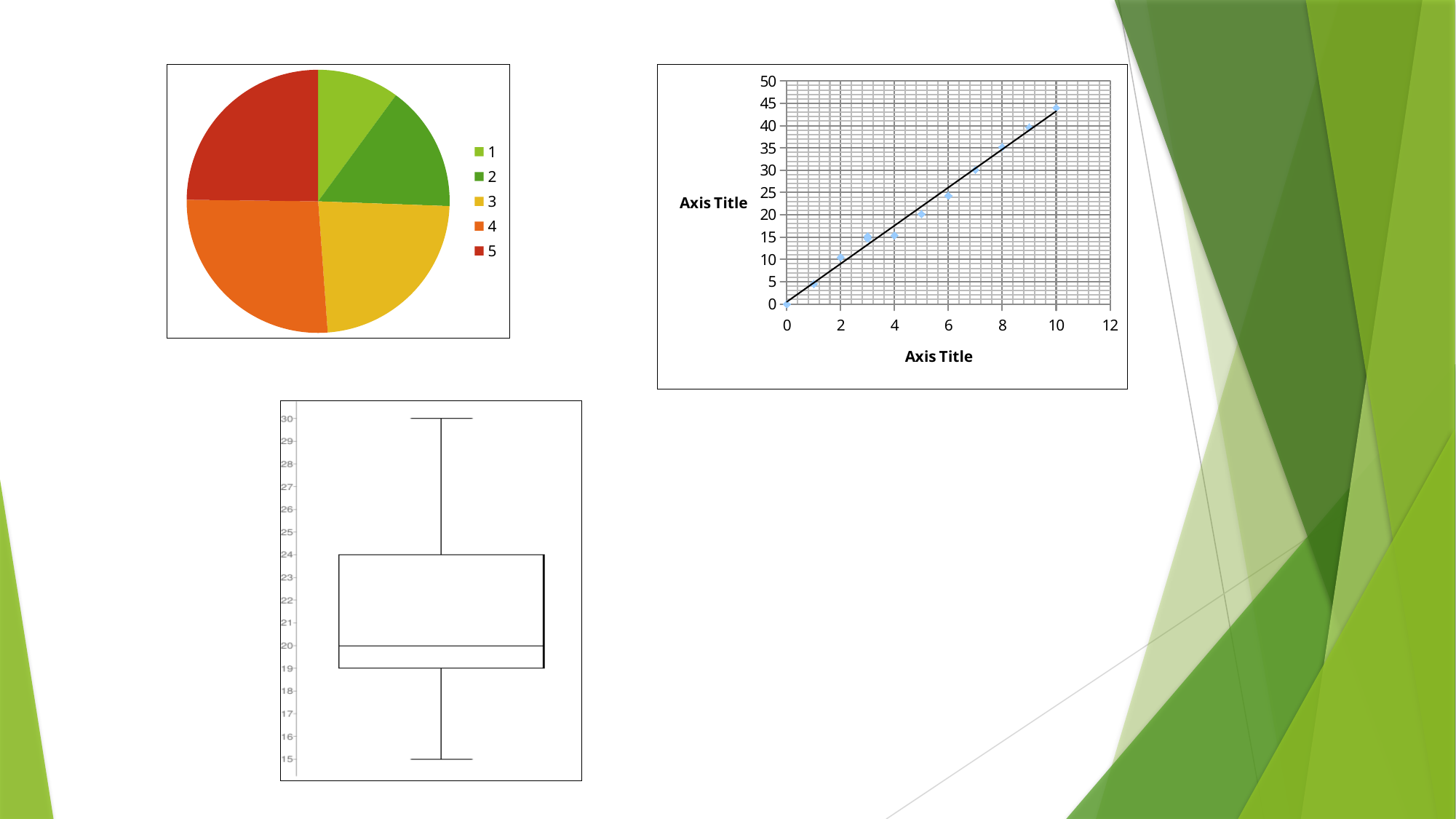
What kind of chart is the top-right chart on the slide? scatter chart In the top-right scatter chart, is the value at x = 10 greater or less than 40? greater How many entries does the legend of the top-left pie chart list? 5 In the top-left pie chart, what colour is slice 5? red What kind of chart is the bottom-left chart on the slide? box plot In the top-left pie chart, which slice is the smallest? 1 In the top-right scatter chart, is the value at x = 2 greater or less than 15? less In the top-left pie chart, which slice is larger, 1 or 2? 2 In the bottom-left box plot, what is the median value? 20 In the bottom-left box plot, what is the difference between the top whisker and the bottom whisker? 15 What kind of chart is the top-left chart on the slide? pie chart In the top-right scatter chart, do the values rise or fall as x increases? rise